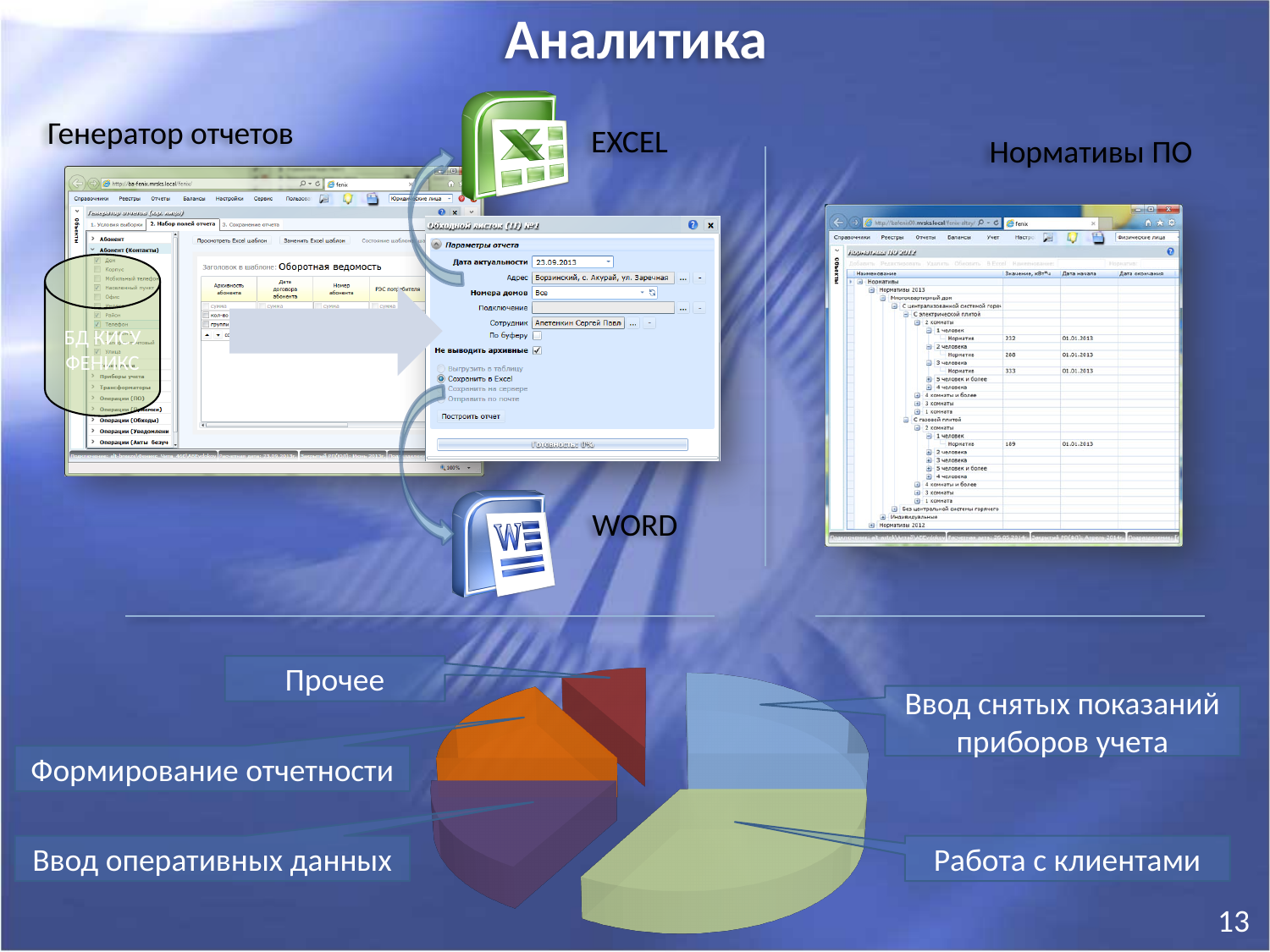
Which is larger in the pie chart: the slice for Прочее or the slice for Работа с клиентами? Работа с клиентами What is the title of the slide containing the pie chart? Аналитика Which slice of the pie chart is the smallest? Прочее Which is larger in the pie chart: the slice for Ввод снятых показаний приборов учета or the slice for Прочее? Ввод снятых показаний приборов учета Which is larger in the pie chart: the slice for Работа с клиентами or the slice for Ввод оперативных данных? Работа с клиентами What kind of chart is shown at the bottom of the slide? pie chart How many slices does the pie chart have? 5 What colour is the Прочее slice of the pie chart? red